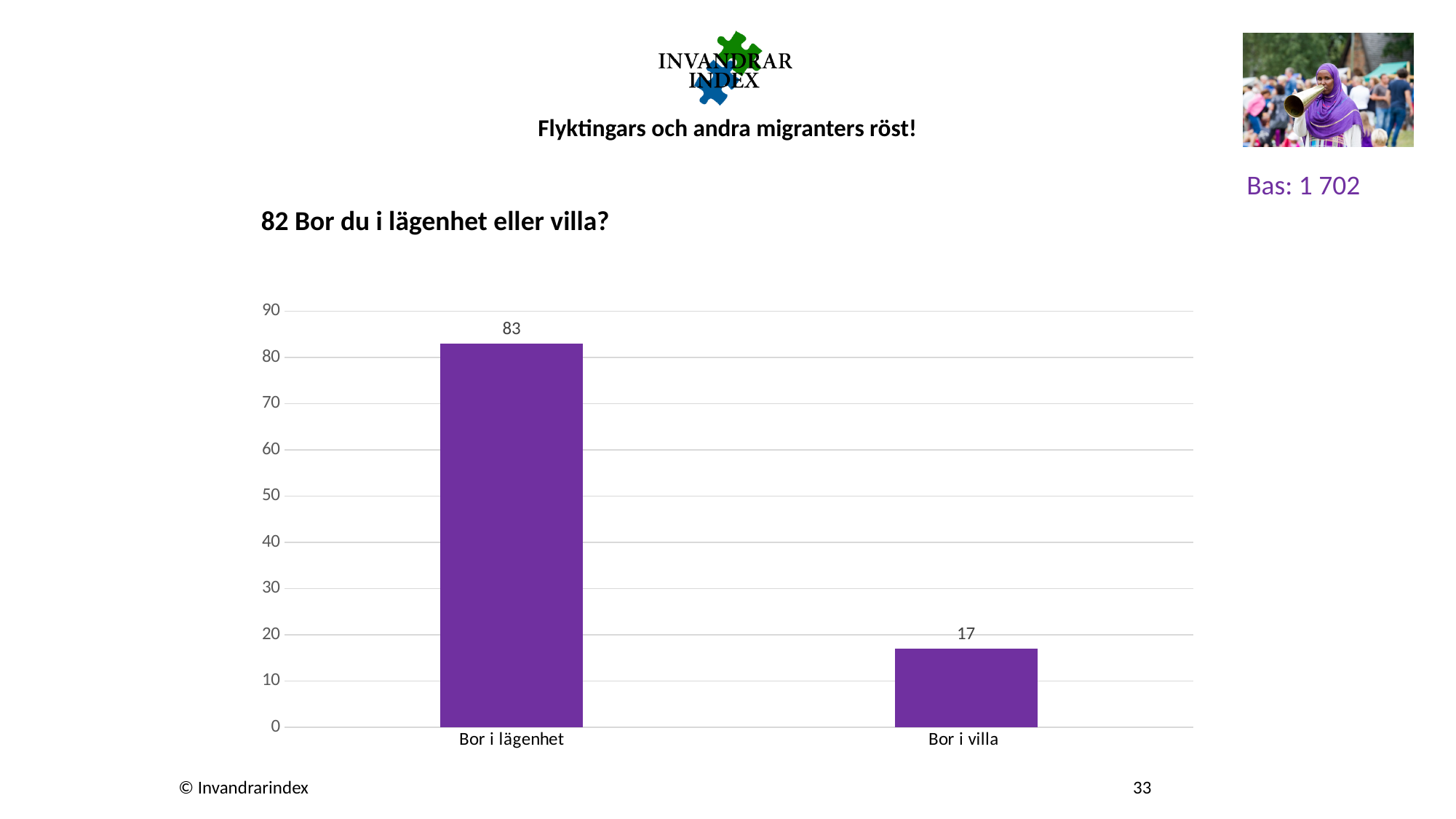
What is the difference between the values for "Bor i lägenhet" and "Bor i villa"? 66 What is the value for "Bor i lägenhet"? 83 Is the value for "Bor i lägenhet" greater or less than 80? greater Which is larger, the value for "Bor i lägenhet" or the value for "Bor i villa"? Bor i lägenhet How many categories are shown in the chart? 2 What is the highest value shown on the vertical axis? 90 Which category has the lowest value? Bor i villa What is the title of the chart? 82 Bor du i lägenhet eller villa? Is the value for "Bor i villa" greater or less than 20? less Which category has the highest value? Bor i lägenhet What is the value for "Bor i villa"? 17 What kind of chart is shown on the slide? bar chart